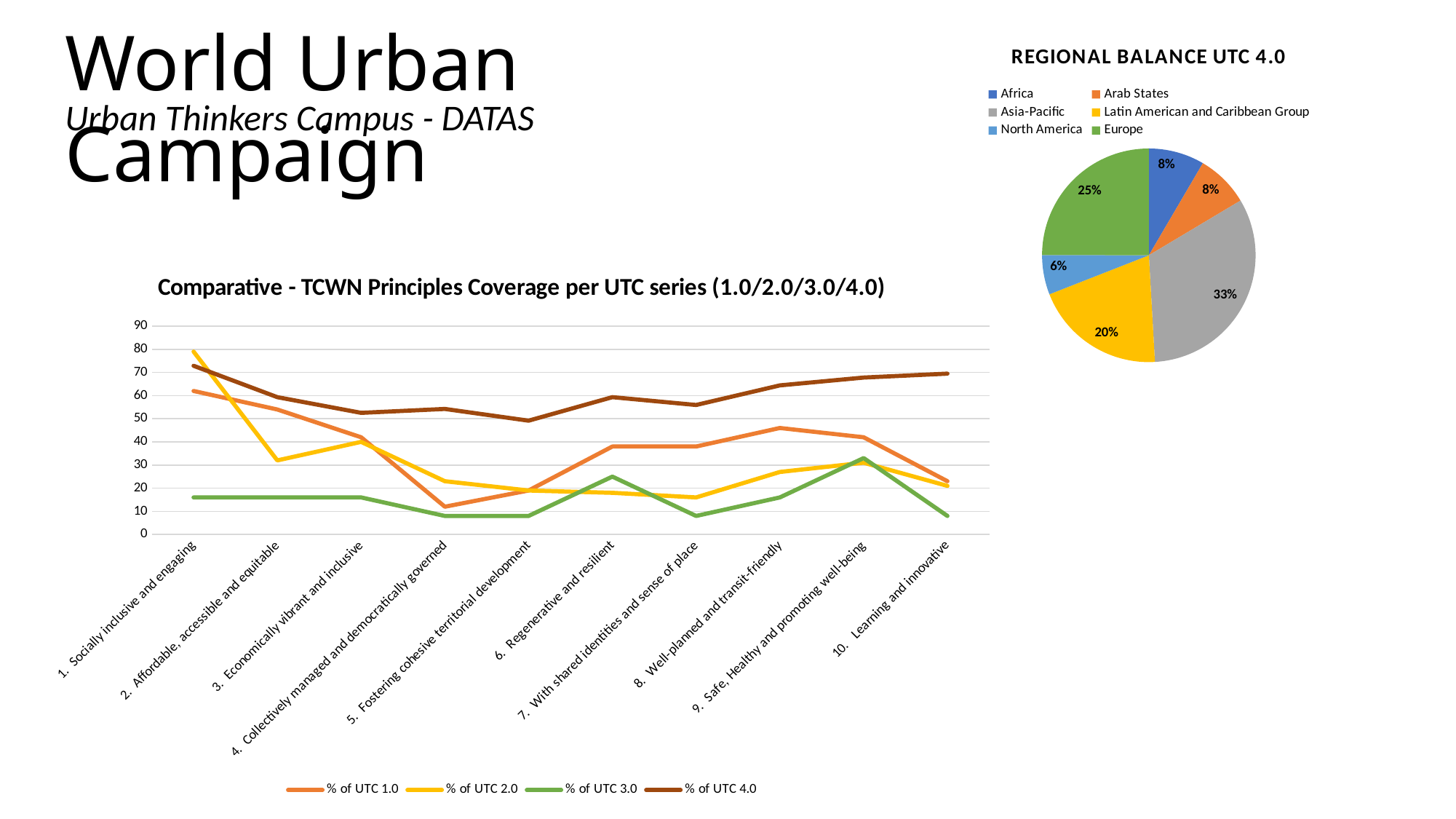
What kind of chart is the REGIONAL BALANCE UTC 4.0 chart? Pie chart In the REGIONAL BALANCE UTC 4.0 pie chart, what share does Asia-Pacific have? 33% In the Comparative - TCWN Principles Coverage chart, how many series does the legend list? 4 In the Comparative - TCWN Principles Coverage chart, is the value of % of UTC 1.0 for '4. Collectively managed and democratically governed' greater or less than 20? less In the Comparative - TCWN Principles Coverage chart, how many principles are shown on the x axis? 10 In the Comparative - TCWN Principles Coverage chart, is the value of % of UTC 4.0 for '10. Learning and innovative' greater or less than 60? greater In the REGIONAL BALANCE UTC 4.0 pie chart, what is the difference between the shares of Europe and the Latin American and Caribbean Group? 5% In the REGIONAL BALANCE UTC 4.0 pie chart, which region has the largest share? Asia-Pacific What kind of chart is the Comparative - TCWN Principles Coverage per UTC series chart? Line chart In the REGIONAL BALANCE UTC 4.0 pie chart, which region has the smallest share? North America In the REGIONAL BALANCE UTC 4.0 pie chart, how many regions are shown? 6 In the REGIONAL BALANCE UTC 4.0 pie chart, what share does Europe have? 25%